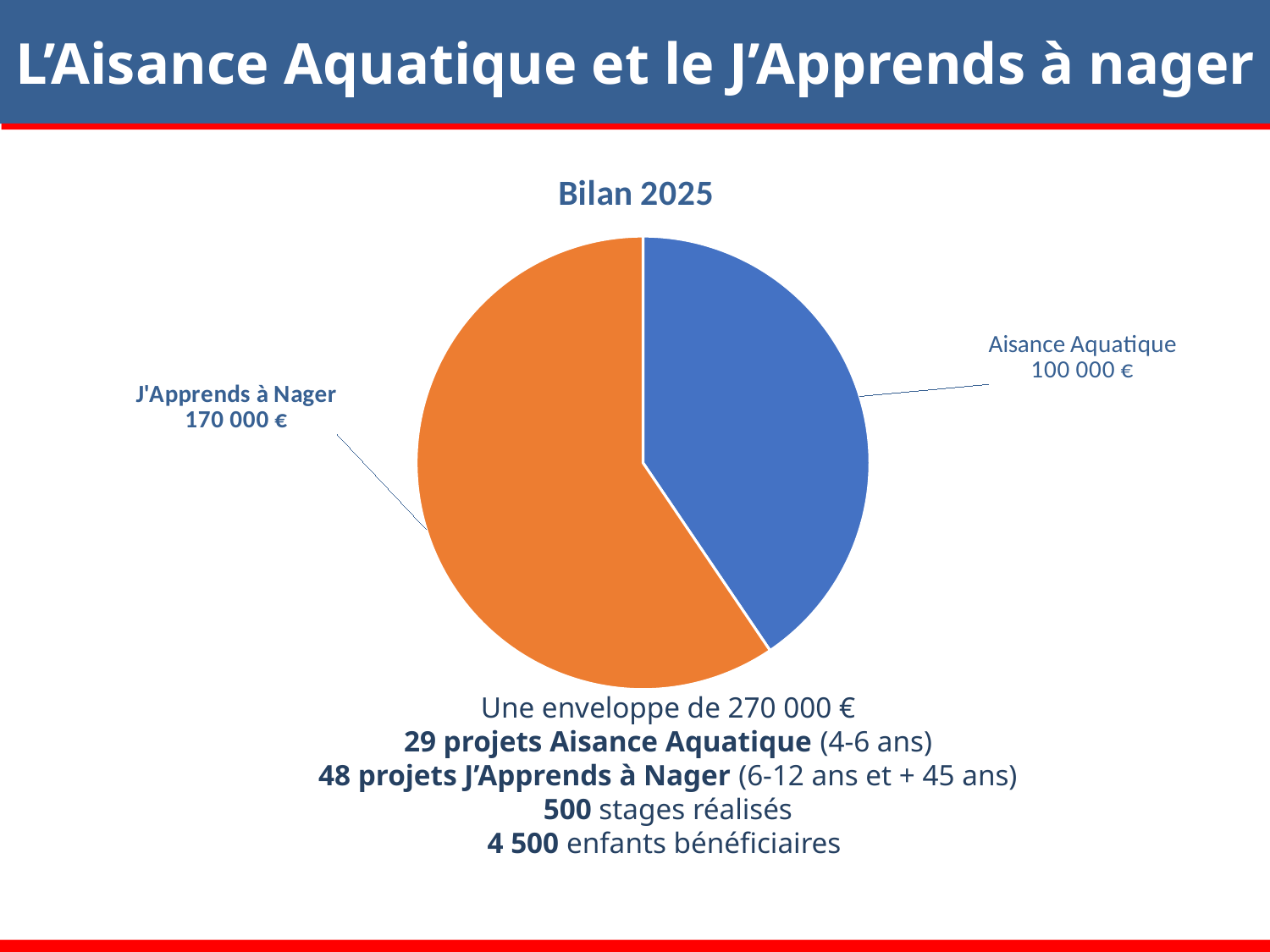
What is the value for Aisance Aquatique in the pie chart? 100 000 € What is the total of the two values shown in the pie chart? 270 000 € Which slice of the pie chart is the smallest? Aisance Aquatique What is the value for J'Apprends à Nager in the pie chart? 170 000 € What kind of chart is shown on the slide? Pie chart What is the difference between the J'Apprends à Nager and Aisance Aquatique values? 70 000 € Which slice of the pie chart is the largest? J'Apprends à Nager What is the title of the chart? Bilan 2025 How many slices does the pie chart have? 2 Which is larger, the value for Aisance Aquatique or the value for J'Apprends à Nager? J'Apprends à Nager What colour is the Aisance Aquatique slice? Blue